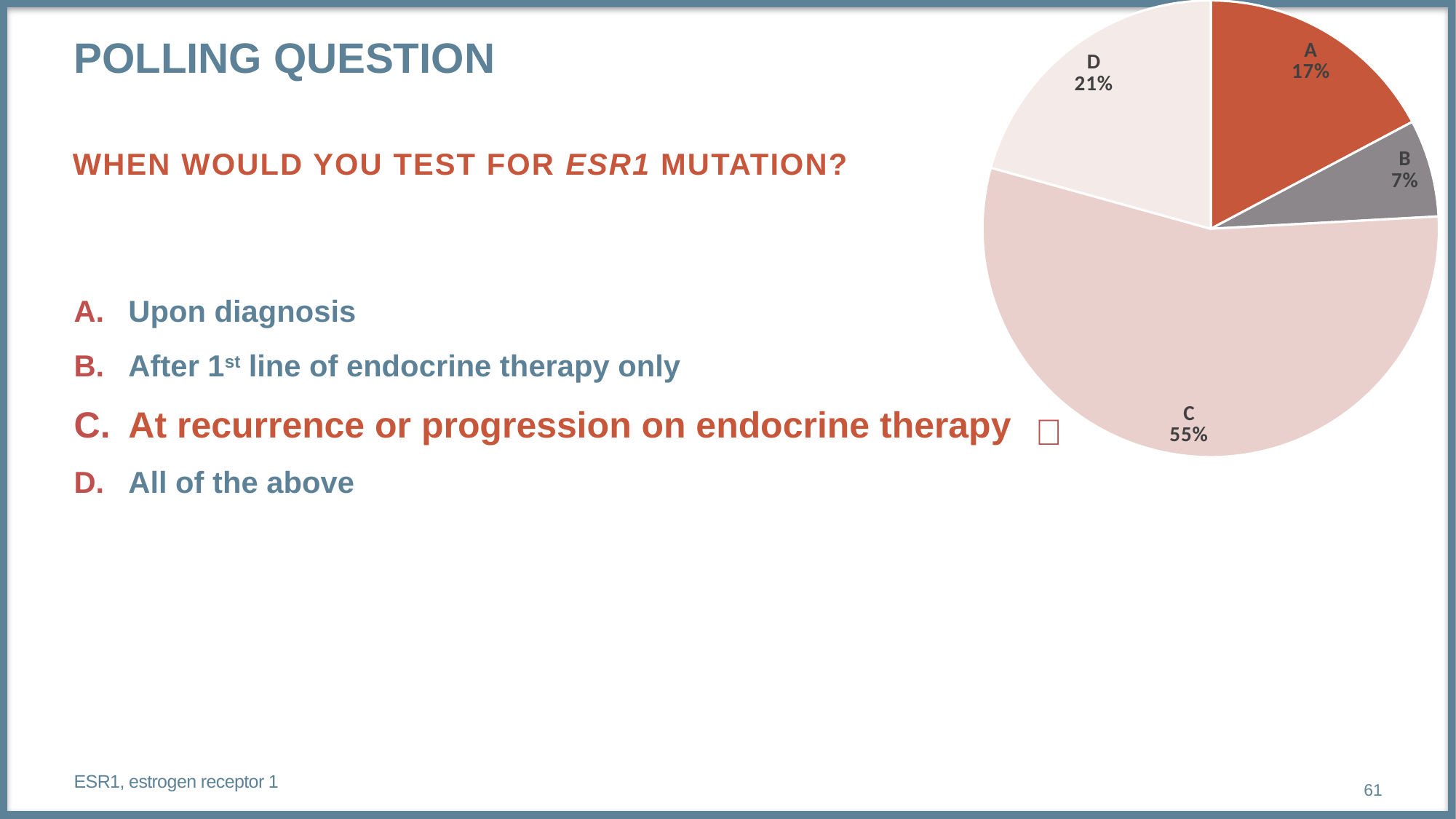
What percentage of the pie is slice A? 17% What percentage of the pie is slice C? 55% How many slices does the pie chart have? 4 Which is larger, slice A or slice D? D What is the combined percentage of slices A and B? 24% Which slice of the pie is the largest? C What is the difference in percentage points between slice C and slice D? 34 What kind of chart is shown on the slide? pie chart What percentage of the pie is slice B? 7% Which slice of the pie is the smallest? B Which slice of the pie is coloured dark grey? B What percentage of the pie is slice D? 21%